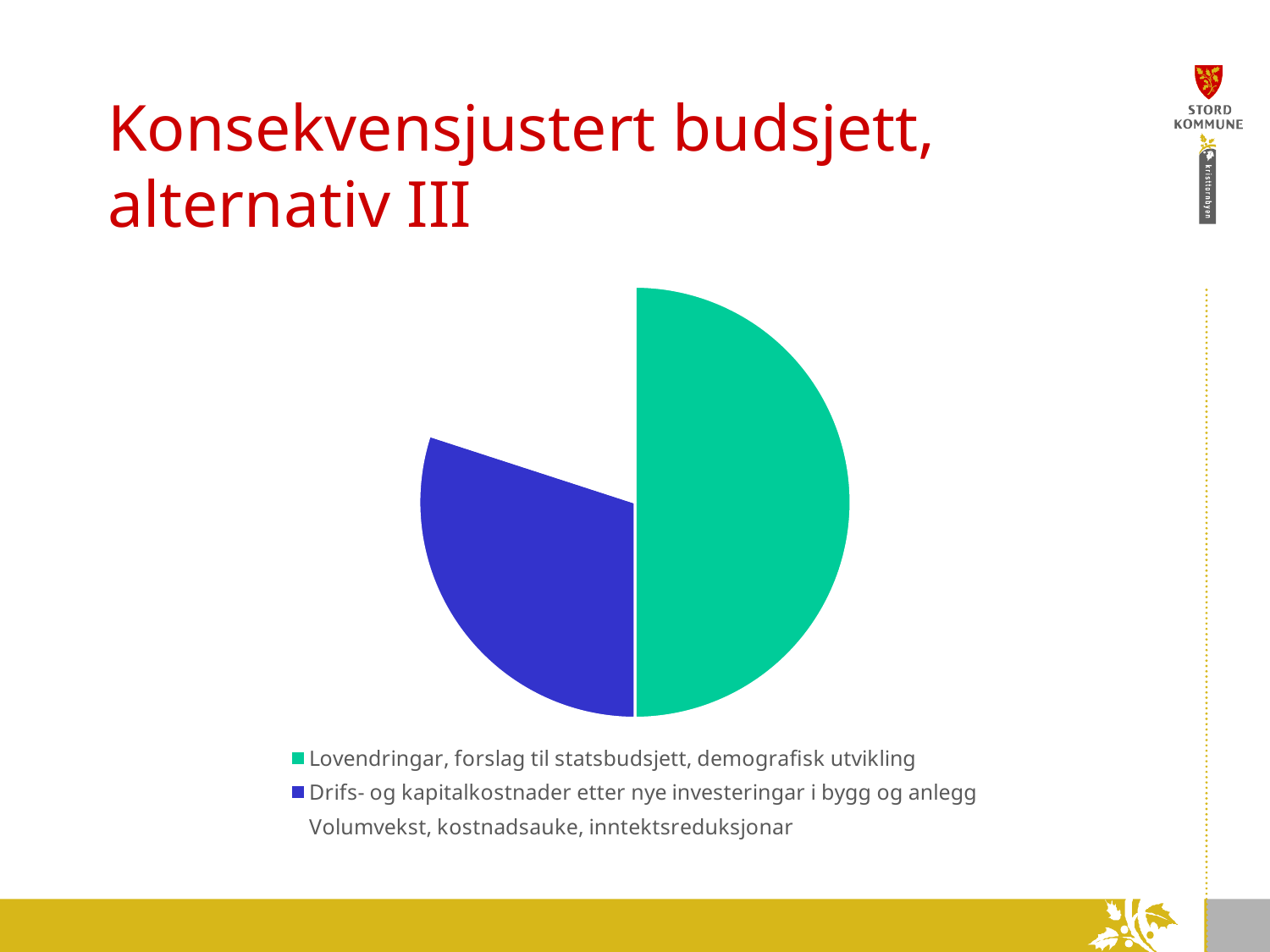
What colour is the slice for "Drifs- og kapitalkostnader etter nye investeringar i bygg og anlegg" in the pie chart? blue Which category has the smallest slice of the pie chart? Volumvekst, kostnadsauke, inntektsreduksjonar Which slice is larger: "Drifs- og kapitalkostnader etter nye investeringar i bygg og anlegg" or "Volumvekst, kostnadsauke, inntektsreduksjonar"? Drifs- og kapitalkostnader etter nye investeringar i bygg og anlegg Which slice is larger: "Lovendringar, forslag til statsbudsjett, demografisk utvikling" or "Drifs- og kapitalkostnader etter nye investeringar i bygg og anlegg"? Lovendringar, forslag til statsbudsjett, demografisk utvikling What kind of chart is shown on the slide? pie chart How many categories does the legend of the pie chart list? 3 Which category has the largest slice of the pie chart? Lovendringar, forslag til statsbudsjett, demografisk utvikling What is the title of the slide containing the pie chart? Konsekvensjustert budsjett, alternativ III